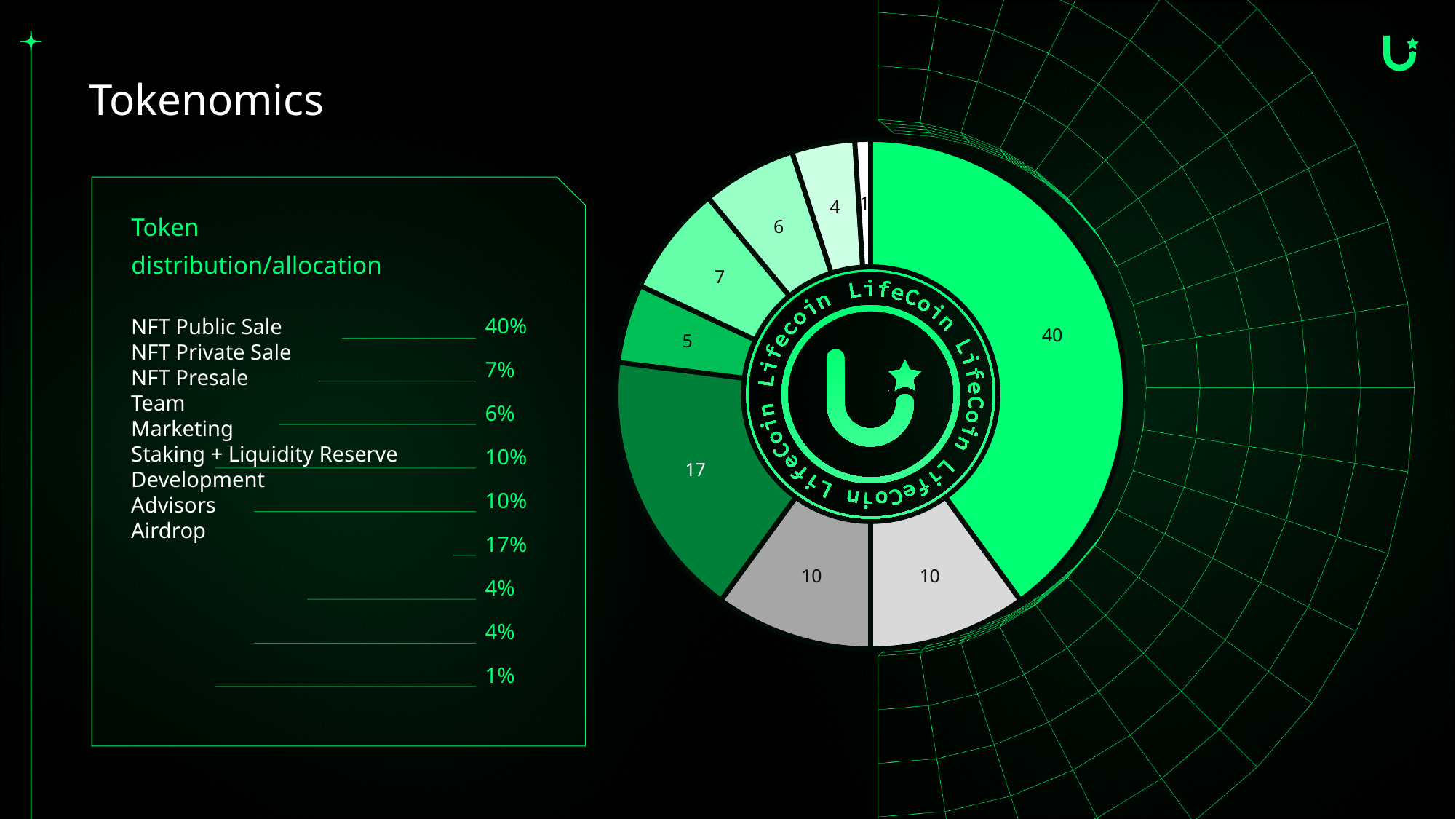
How many slices in the pie chart are labeled 10? 2 What share of the pie does the slice labeled 40 represent? 40% What is the value of the smallest slice in the pie chart? 1 What is the difference between the largest and smallest slice values in the pie chart? 39 What is the combined value of the two slices labeled 10 in the pie chart? 20 What kind of chart is shown on the slide? doughnut chart According to the allocation list, what percentage is allocated to NFT Public Sale? 40% What is the heading of the allocation list next to the pie chart? Token distribution/allocation How many categories are listed in the token allocation list? 9 According to the allocation list, what percentage is allocated to Airdrop? 1% What is the value of the largest slice in the pie chart? 40 How many slices does the pie chart have? 9